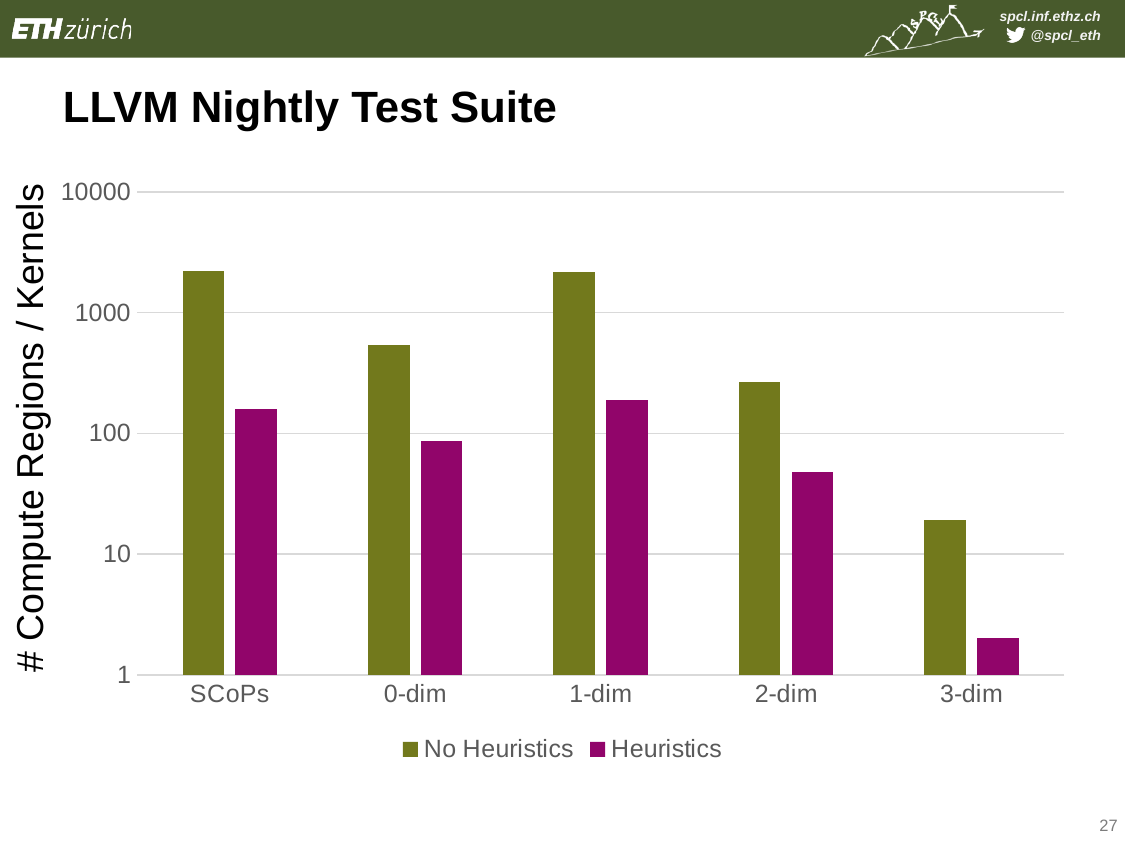
How many categories are shown on the x axis? 5 What is the label of the y axis? # Compute Regions / Kernels Is the No Heuristics value for 0-dim greater or less than 1000? less Which series is shown in purple? Heuristics Which category has the lowest Heuristics value? 3-dim Is the No Heuristics value for SCoPs greater or less than 1000? greater How many series does the legend list? 2 Is the Heuristics value for 3-dim greater or less than 10? less What kind of chart is shown on the slide? bar chart For 1-dim, which is larger: the No Heuristics value or the Heuristics value? No Heuristics